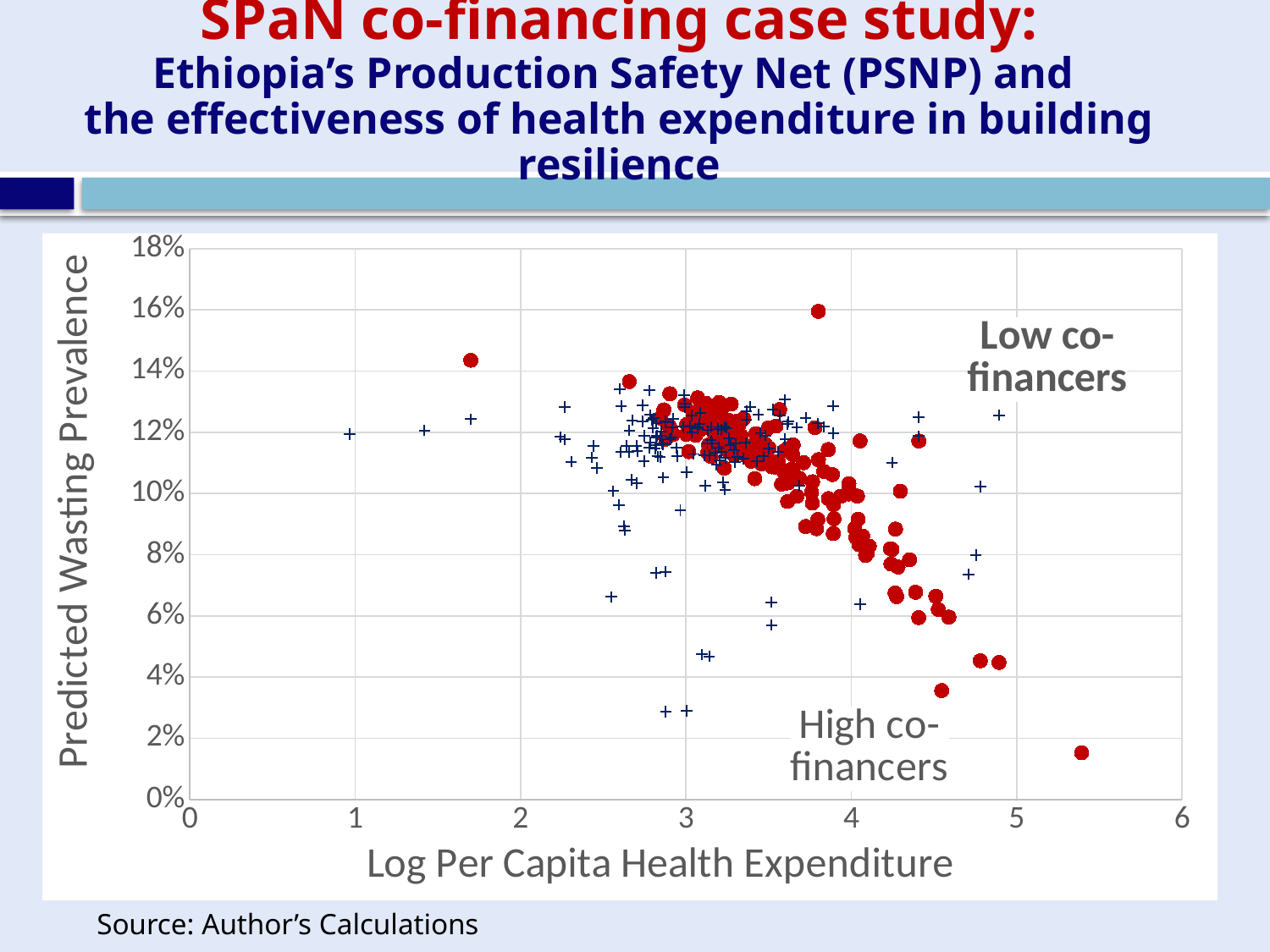
What is the maximum value shown on the y axis? 18% Which group of points is shown as red circles? High co-financers How many groups of points are plotted on the chart? 2 What is the maximum value shown on the x axis? 6 Which group has the point with the highest log per capita health expenditure, High co-financers or Low co-financers? High co-financers Is the highest red (High co-financers) point greater or less than 14% predicted wasting prevalence? greater Is the predicted wasting prevalence of the leftmost blue cross (Low co-financers) greater or less than 10%? greater Do the red (High co-financers) points rise or fall in predicted wasting prevalence as log per capita health expenditure increases? Fall What kind of chart is shown on the slide? Scatter plot Is the lowest red (High co-financers) point greater or less than 2% predicted wasting prevalence? less